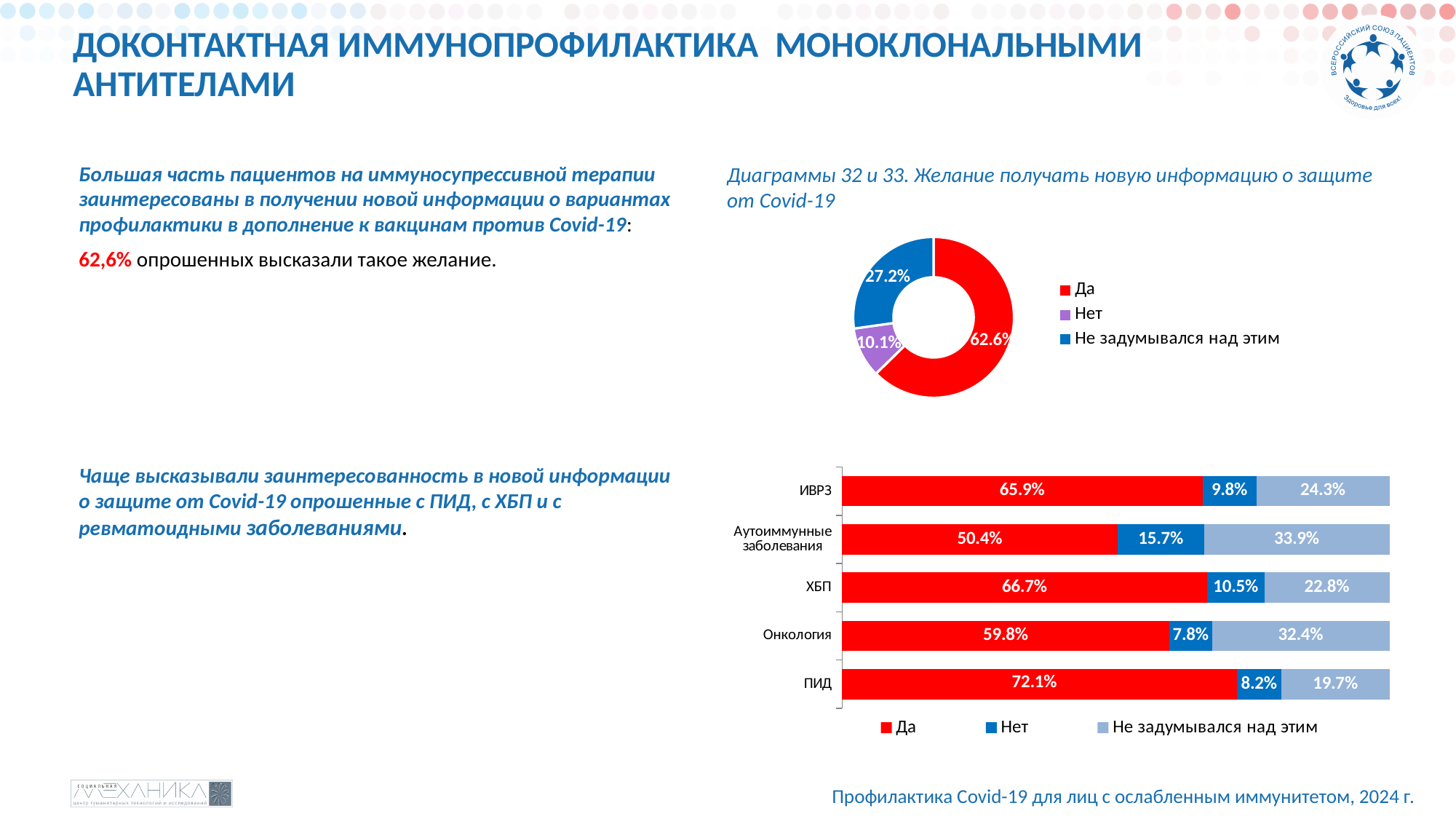
In the bar chart at the bottom of the slide, what is the "Да" value for ПИД? 72.1% In the donut chart at the top of the slide, what share of respondents answered "Нет"? 10.1% What kind of chart is shown at the top of the slide? Pie (donut) chart In the bar chart at the bottom of the slide, what is the "Нет" value for Аутоиммунные заболевания? 15.7% In the bar chart at the bottom of the slide, which is larger: the "Не задумывался над этим" value for Онкология or for ХБП? Онкология In the bar chart at the bottom of the slide, which category has the highest "Да" value? ПИД How many series does the legend of the bar chart at the bottom of the slide list? 3 How many categories are shown in the bar chart at the bottom of the slide? 5 In the donut chart at the top of the slide, what share of respondents answered "Да"? 62.6% In the donut chart at the top of the slide, what is the difference between the "Да" share and the "Не задумывался над этим" share? 35.4% In the bar chart at the bottom of the slide, which category has the lowest "Да" value? Аутоиммунные заболевания In the donut chart at the top of the slide, which answer has the smallest share? Нет